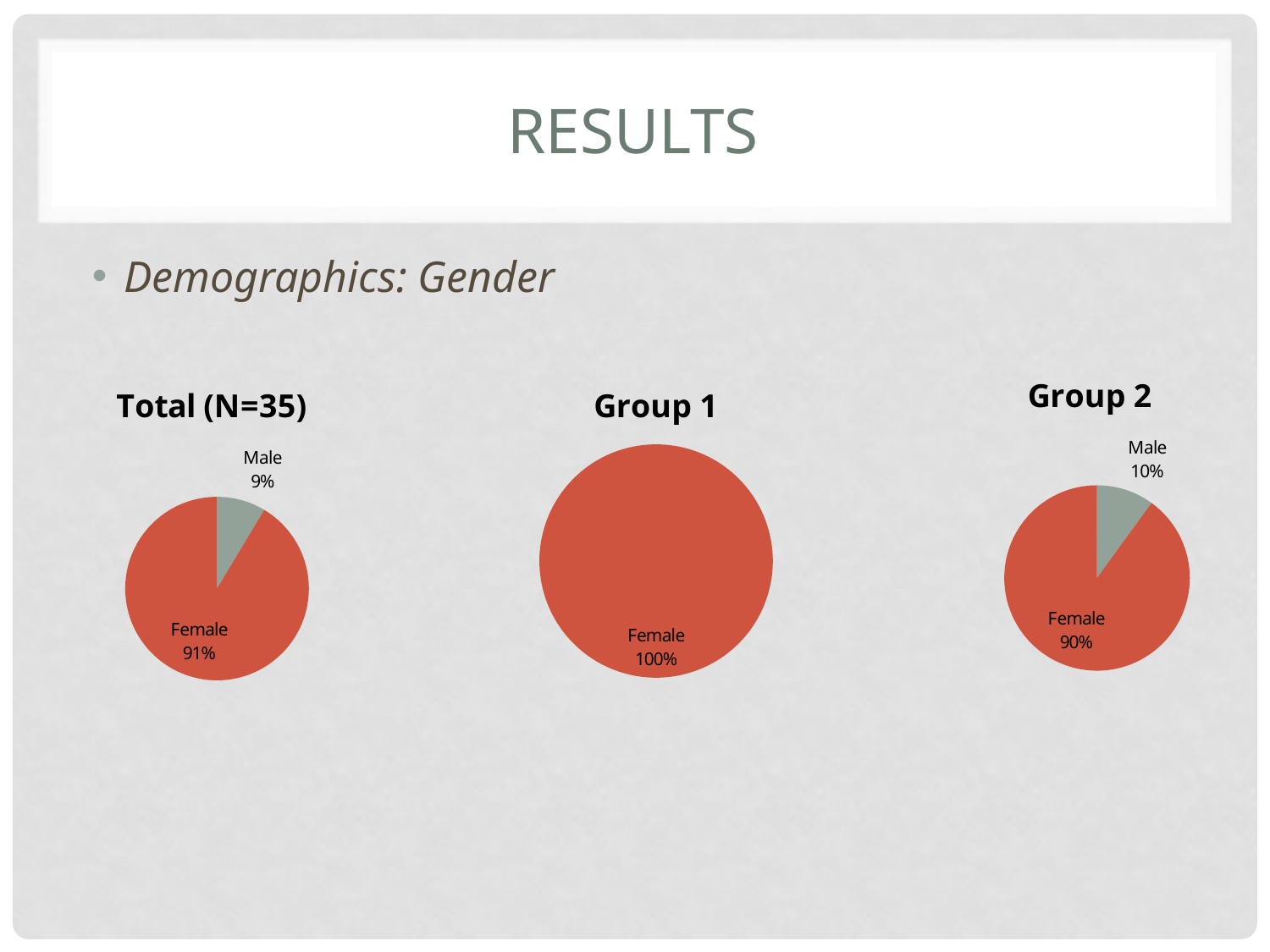
In the 'Group 2' chart, what is the difference between the Female and Male shares? 80% How many pie charts are shown on the slide? 3 In the 'Group 1' chart, what share of the pie is Female? 100% In the 'Group 2' chart, what share of the pie is Male? 10% In the 'Total (N=35)' chart, which slice is the largest? Female In the 'Total (N=35)' chart, what is the difference between the Female and Male shares? 82% How many slices does the 'Group 1' chart have? 1 In the 'Total (N=35)' chart, what share of the pie is Female? 91% What kind of chart is the 'Group 1' chart? Pie chart In the 'Group 2' chart, which slice is the smallest? Male